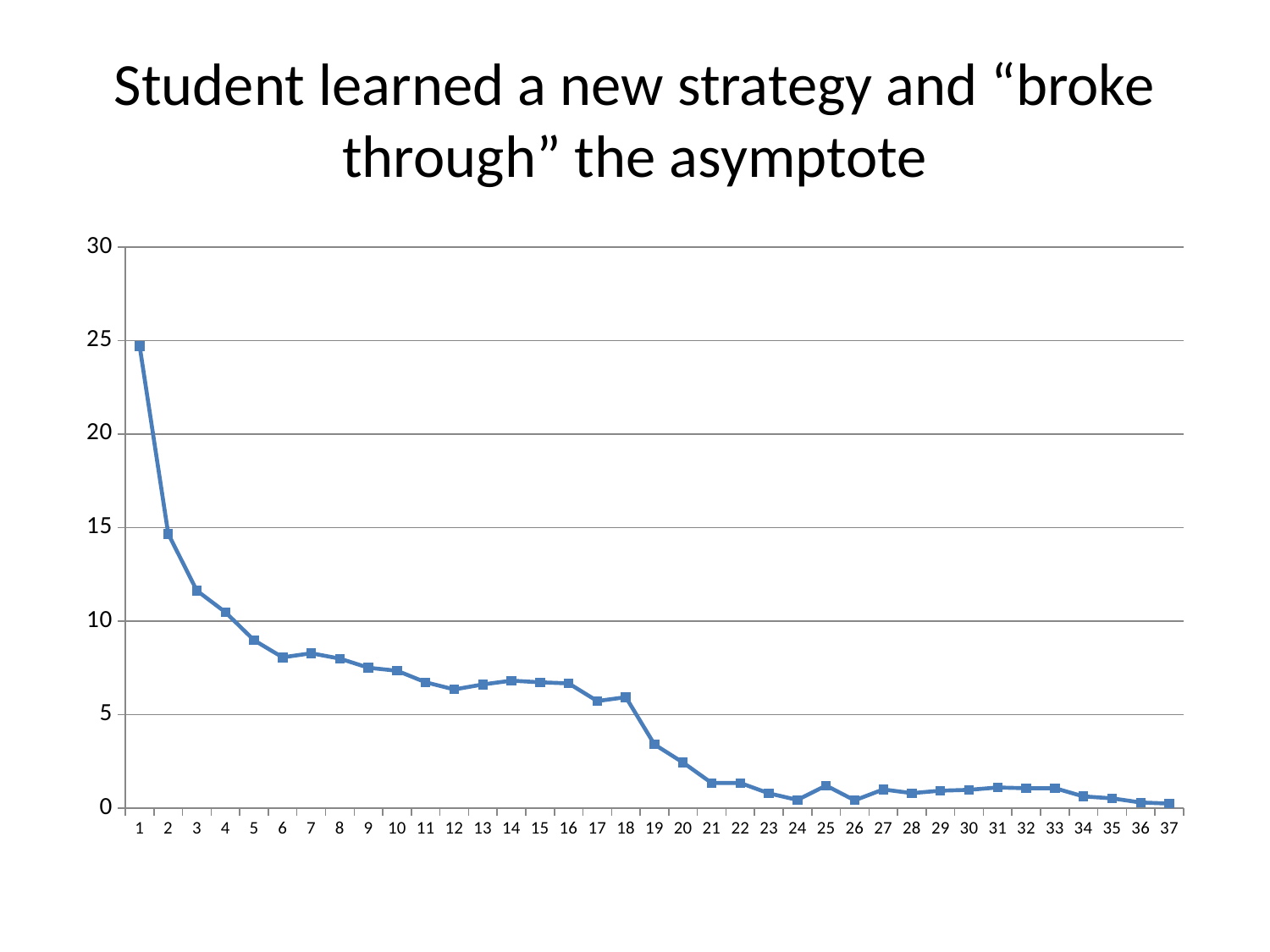
Is the value at point 3 greater or less than 10? greater What kind of chart is shown on the slide? line chart Is the value at point 12 greater or less than 5? greater Which has the larger value, point 18 or point 19? point 18 How many data points are plotted along the x axis? 37 What is the title of the slide containing the chart? Student learned a new strategy and "broke through" the asymptote At which x-axis point is the value highest? 1 Is the value at point 19 greater or less than 5? less Do the values generally rise or fall as the x axis goes from 1 to 37? fall Which has the larger value, point 5 or point 25? point 5